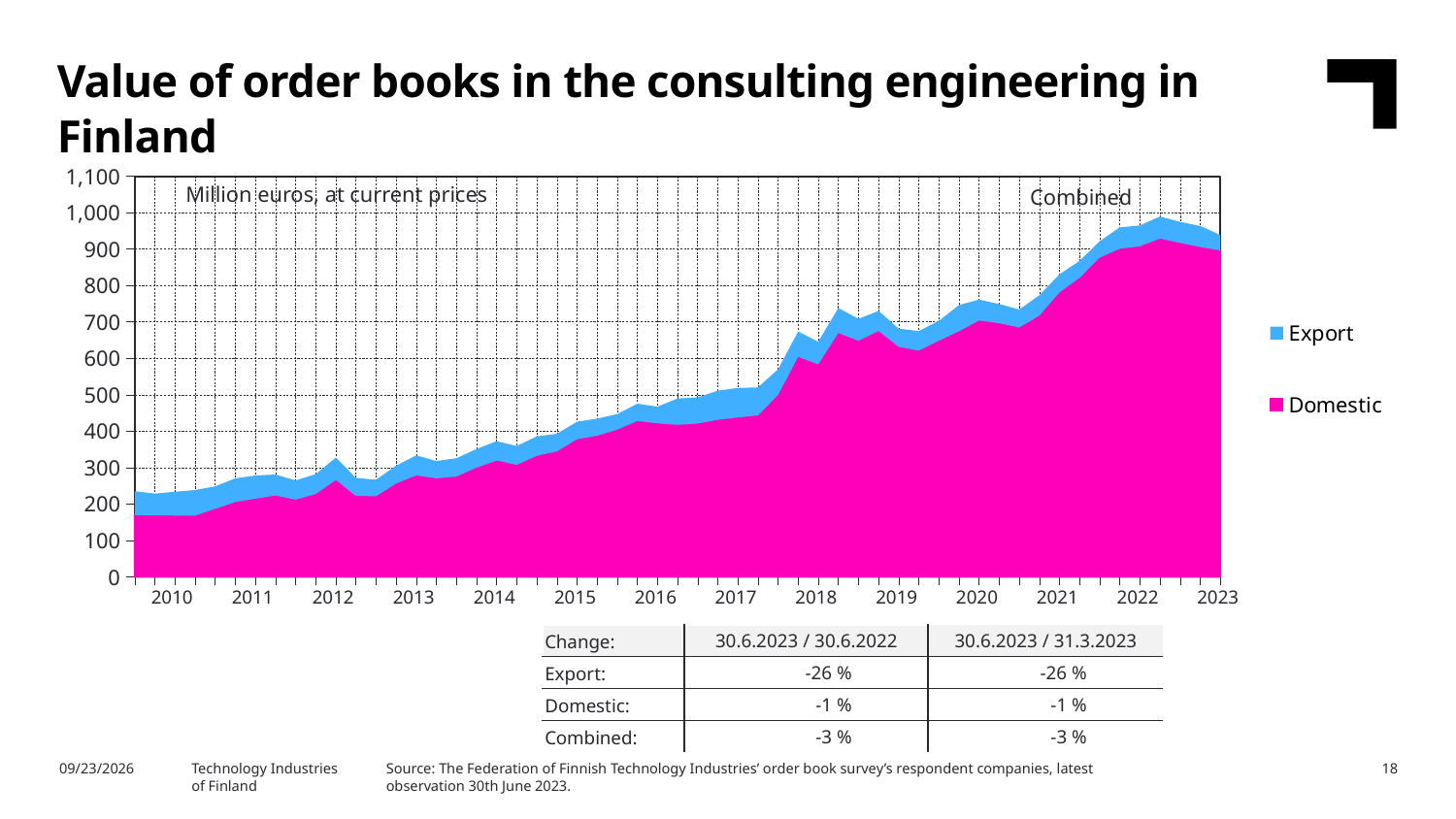
According to the table, what is the change in Export order books from 30.6.2022 to 30.6.2023? -26 % In which year does the combined value reach its highest point on the chart? 2022 Is the Domestic value in 2018 greater or less than 500? greater Is the combined value at the start of 2010 greater or less than 300? less Is the combined value in 2023 greater or less than 800? greater Which series is larger throughout the chart, Export or Domestic? Domestic What are the two series named in the chart legend? Export and Domestic According to the table, what is the change in Combined order books from 31.3.2023 to 30.6.2023? -3 % How many series does the chart legend list? 2 What unit is stated in the chart for the values? Million euros, at current prices What kind of chart is shown on the slide? Stacked area chart Do the combined order book values generally rise or fall from 2010 to 2022? Rise